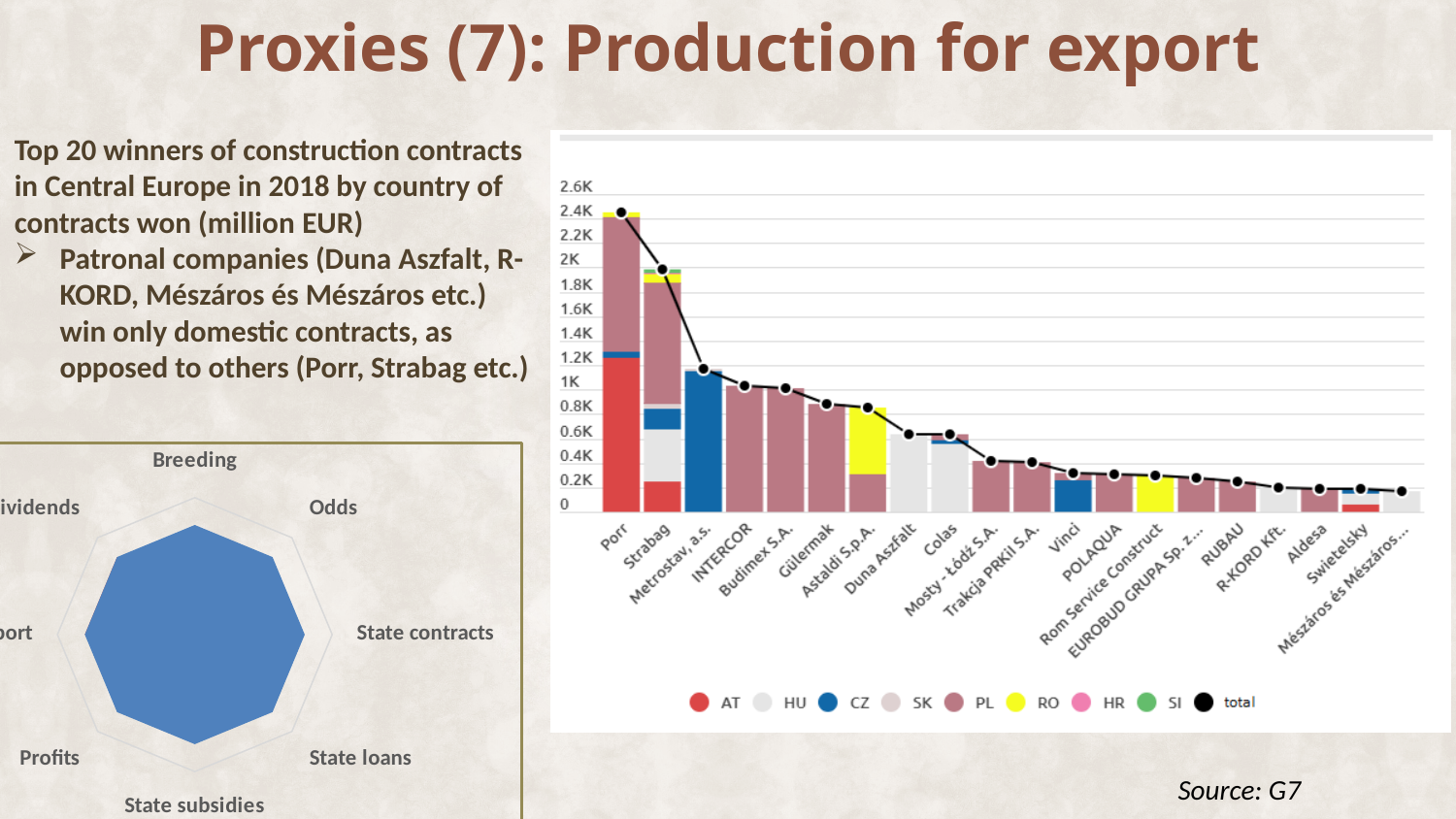
In the bar chart on the right, which has the larger total, Porr or Strabag? Porr In the bar chart on the right, do the totals rise or fall from left to right along the x axis? fall In the legend of the bar chart on the right, which country is shown in yellow? RO In the bar chart on the right, which has the larger total, Vinci or Duna Aszfalt? Duna Aszfalt In the bar chart on the right, which company has the highest total? Porr In the bar chart on the right, is the total for Astaldi S.p.A. greater or less than 0.6K? greater In the bar chart on the right, is the total for Metrostav a.s. greater or less than 1.4K? less How many entries does the legend of the bar chart on the right list? 9 In the bar chart on the right, how many companies are shown on the x axis? 20 In the bar chart on the right, is the total for Porr greater or less than 2K? greater What kind of chart is the chart on the right side of the slide? bar chart What kind of chart is the chart in the lower left of the slide? radar chart